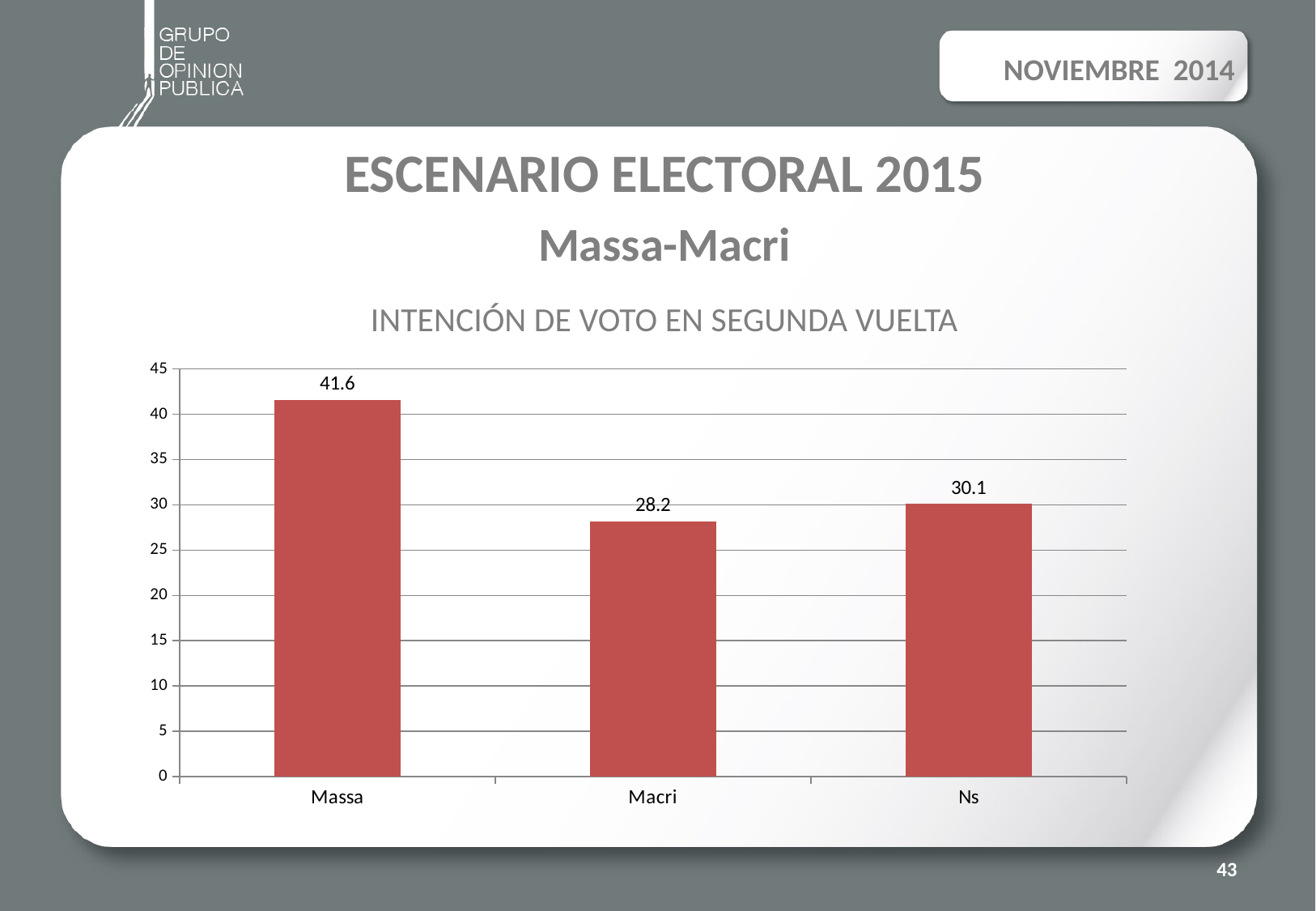
Which is larger, the value for Massa or the value for Ns? Massa What is the difference between the values for Massa and Macri? 13.4 What is the value for Ns? 30.1 Which category has the lowest value? Macri What is the value for Macri? 28.2 What kind of chart is shown on the slide? bar chart What is the value for Massa? 41.6 How many categories are shown on the x axis? 3 What is the difference between the values for Ns and Macri? 1.9 Which category has the highest value? Massa Is the value for Macri greater or less than 30? less What is the title of the chart? INTENCIÓN DE VOTO EN SEGUNDA VUELTA